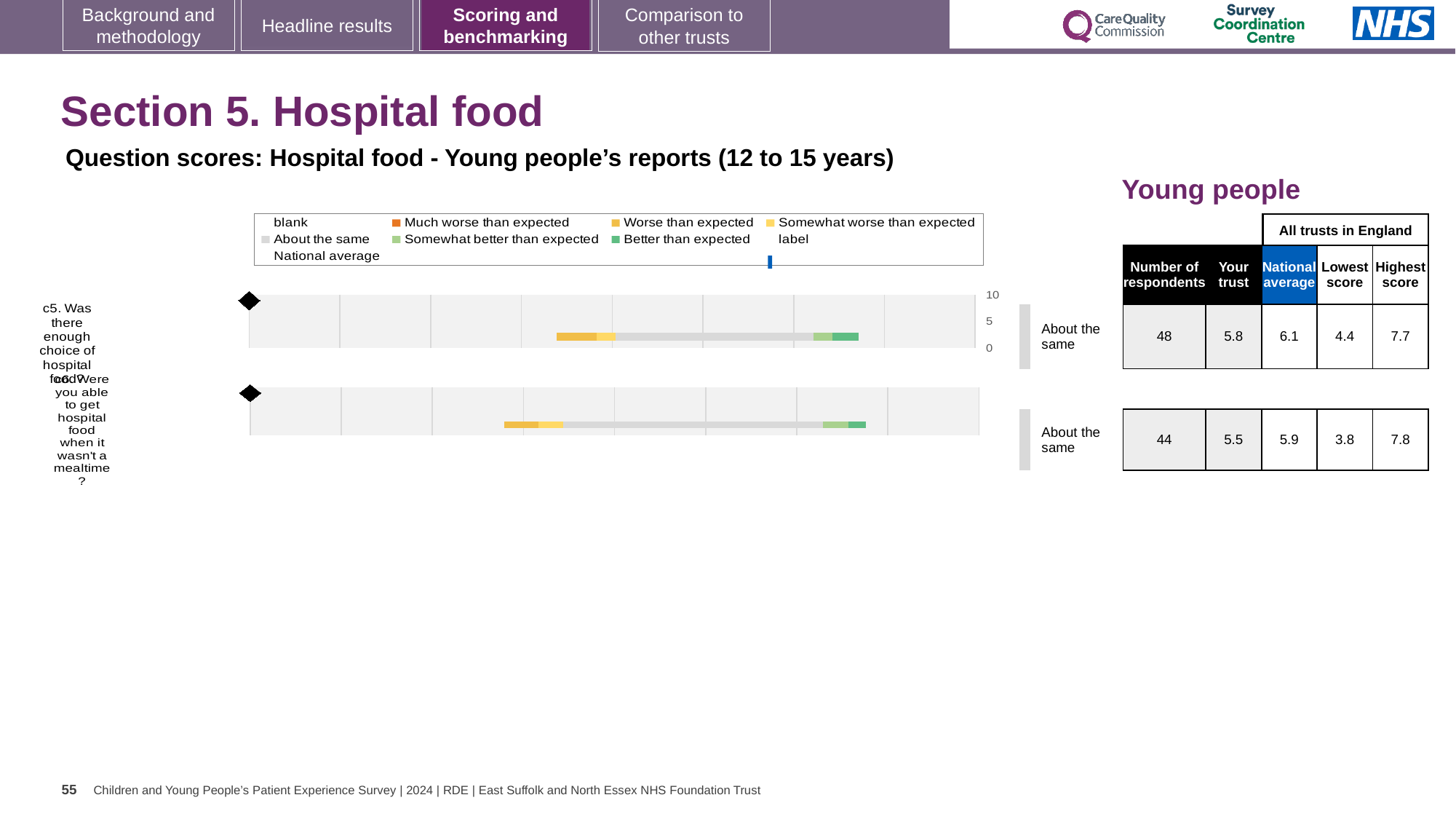
How many questions are plotted in the hospital food chart? 2 What is the difference between the highest and lowest scores for question c5? 3.3 Is the 'Your trust' score for question c6 greater or less than 5? greater Which question has the higher 'Your trust' score, c5 or c6? c5 By how much does the national average exceed the trust's score for question c6? 0.4 Which colour in the legend represents 'Better than expected'? green What is the 'Your trust' score for question c5 (Was there enough choice of hospital food?)? 5.8 What is the lowest score among all trusts in England for question c6? 3.8 What kind of chart is used to show the question scores for hospital food? bar chart How many respondents answered question c5? 48 What is the maximum value shown on the score axis of the chart? 10 What is the national average score for question c6 (Were you able to get hospital food when it wasn't a mealtime?)? 5.9